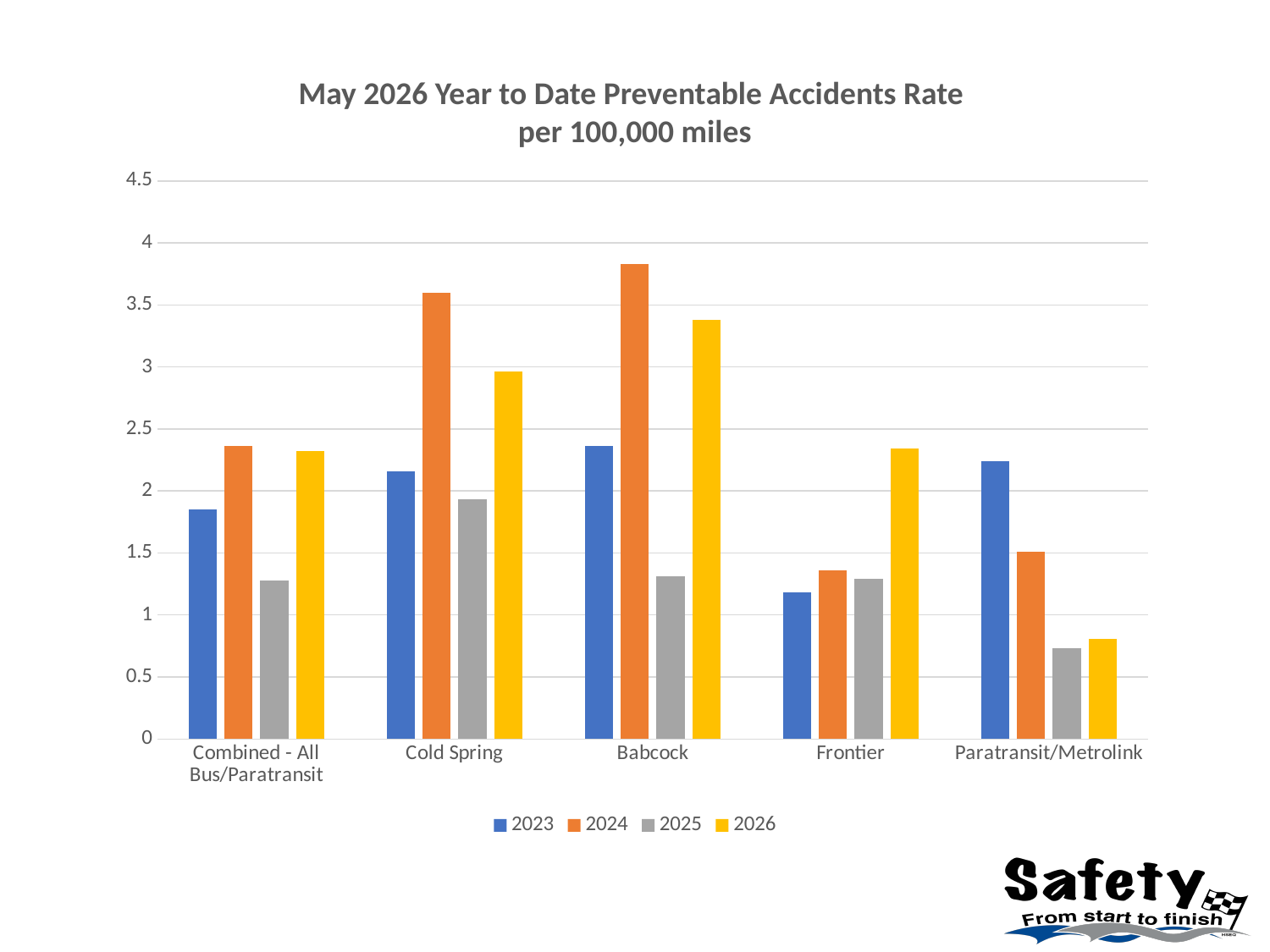
For Frontier, which is larger: the 2023 value or the 2026 value? 2026 Is the 2025 value for Paratransit/Metrolink greater or less than 1? less How many categories are shown along the x axis? 5 Which category has the highest value for 2026? Babcock Is the 2025 value for Babcock greater or less than 1.5? less Which category has the lowest value for 2025? Paratransit/Metrolink Is the 2026 value for Babcock greater or less than 3? greater Which category has the highest value for 2024? Babcock How many series does the legend list? 4 For Paratransit/Metrolink, which is larger: the 2023 value or the 2024 value? 2023 What kind of chart is shown on the slide? bar chart